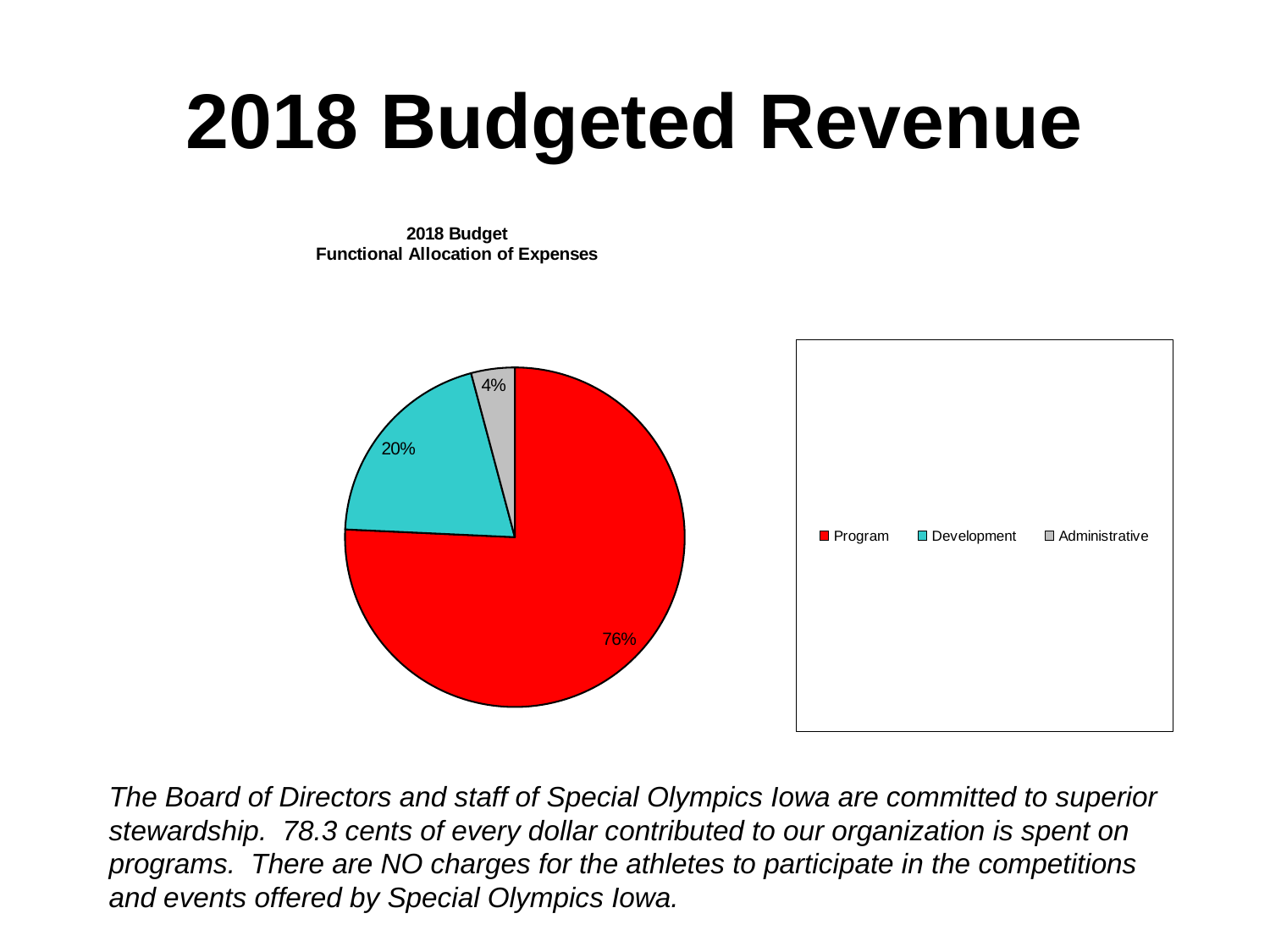
What is the difference in percentage points between the Program and Development shares? 56 What percentage of expenses is allocated to Administrative? 4% What is the chart's title? 2018 Budget Functional Allocation of Expenses What percentage of expenses is allocated to Development? 20% How many categories does the pie chart show? 3 What percentage of expenses is allocated to Program? 76% What colour is the Development slice? Cyan How many entries does the legend list? 3 Which category has the smallest share of the pie? Administrative What kind of chart is shown on the slide? Pie chart Which is larger, the Development share or the Administrative share? Development Which category has the largest share of the pie? Program